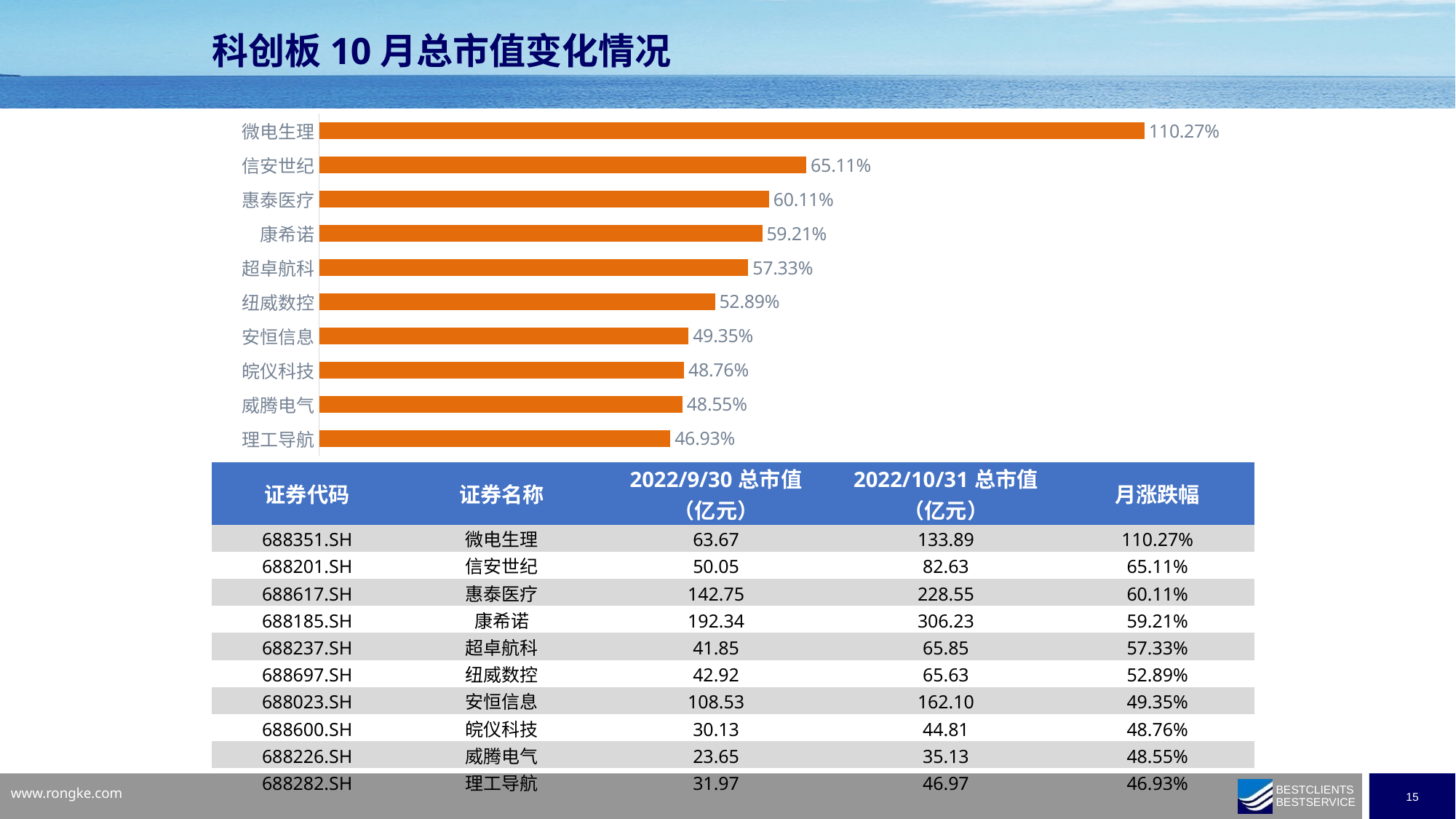
How many categories are shown in the bar chart? 10 What is the difference between the values for 惠泰医疗 and 康希诺 in the bar chart? 0.90% Which has a larger value in the bar chart, 超卓航科 or 安恒信息? 超卓航科 Which category has the lowest value in the bar chart? 理工导航 What is the value shown for 理工导航 in the bar chart? 46.93% What kind of chart is shown on the slide? Bar chart What is the value shown for 纽威数控 in the bar chart? 52.89% Which category has the highest value in the bar chart? 微电生理 What colour are the bars in the chart? Orange What is the difference between the values for 微电生理 and 信安世纪 in the bar chart? 45.16% What is the title of the slide containing the chart? 科创板 10 月总市值变化情况 What is the value shown for 微电生理 in the bar chart? 110.27%